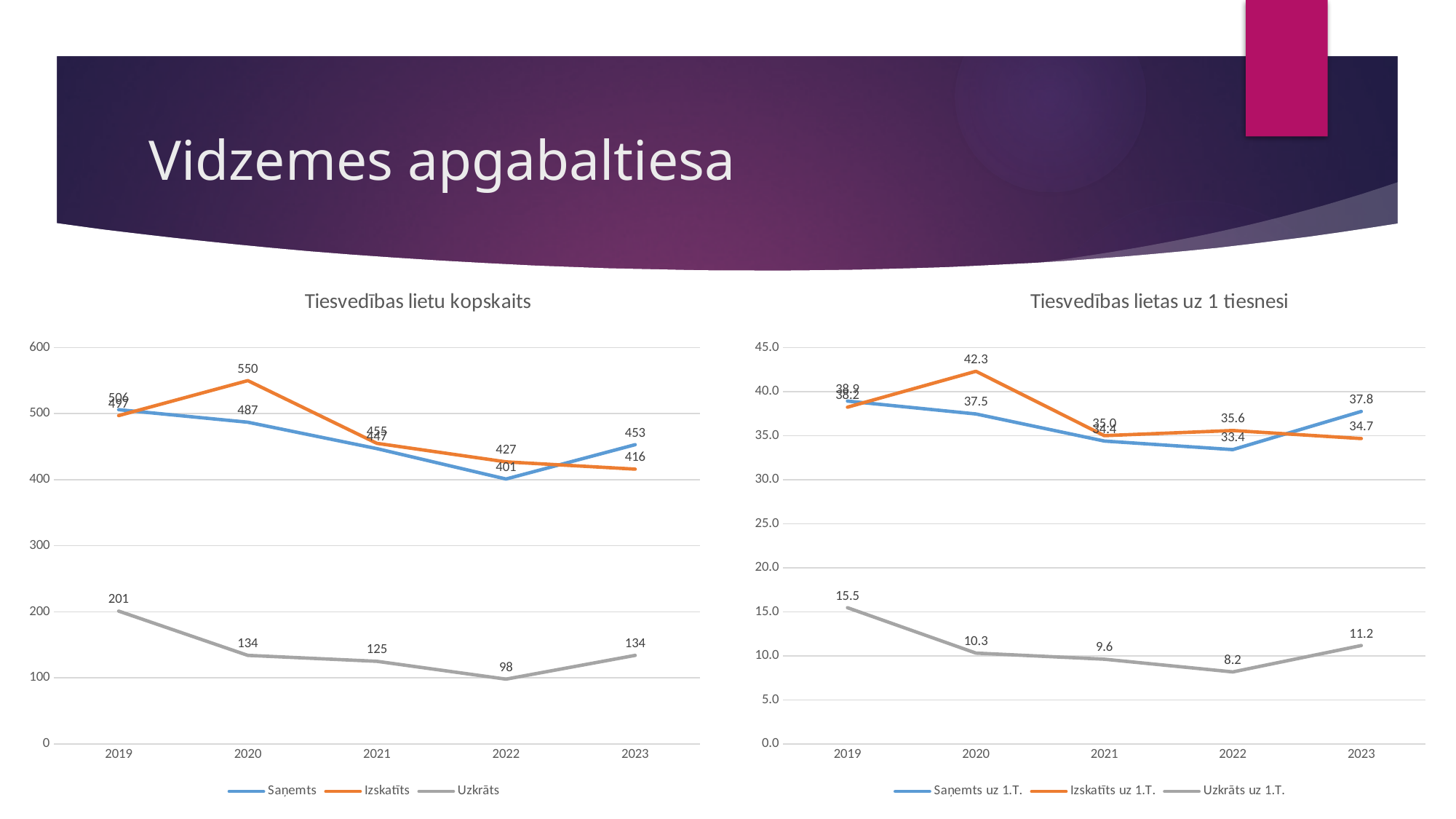
In the chart titled 'Tiesvedības lietu kopskaits', what is the value for Izskatīts in 2020? 550 In the chart titled 'Tiesvedības lietu kopskaits', in which year is the Uzkrāts series lowest? 2022 In the chart titled 'Tiesvedības lietas uz 1 tiesnesi', in which year is Izskatīts uz 1.T. highest? 2020 In the chart titled 'Tiesvedības lietu kopskaits', how many series does the legend list? 3 In the chart titled 'Tiesvedības lietu kopskaits', what is the value for Uzkrāts in 2022? 98 What kind of chart is 'Tiesvedības lietas uz 1 tiesnesi'? Line chart In the chart titled 'Tiesvedības lietu kopskaits', which is larger in 2023: Saņemts or Izskatīts? Saņemts In the chart titled 'Tiesvedības lietas uz 1 tiesnesi', how many years are shown on the x axis? 5 In the chart titled 'Tiesvedības lietas uz 1 tiesnesi', what is the value for Uzkrāts uz 1.T. in 2023? 11.2 In the chart titled 'Tiesvedības lietu kopskaits', what is the value for Saņemts in 2023? 453 In the chart titled 'Tiesvedības lietas uz 1 tiesnesi', what is the value for Izskatīts uz 1.T. in 2020? 42.3 In the chart titled 'Tiesvedības lietu kopskaits', what is the difference between Izskatīts and Saņemts in 2020? 63